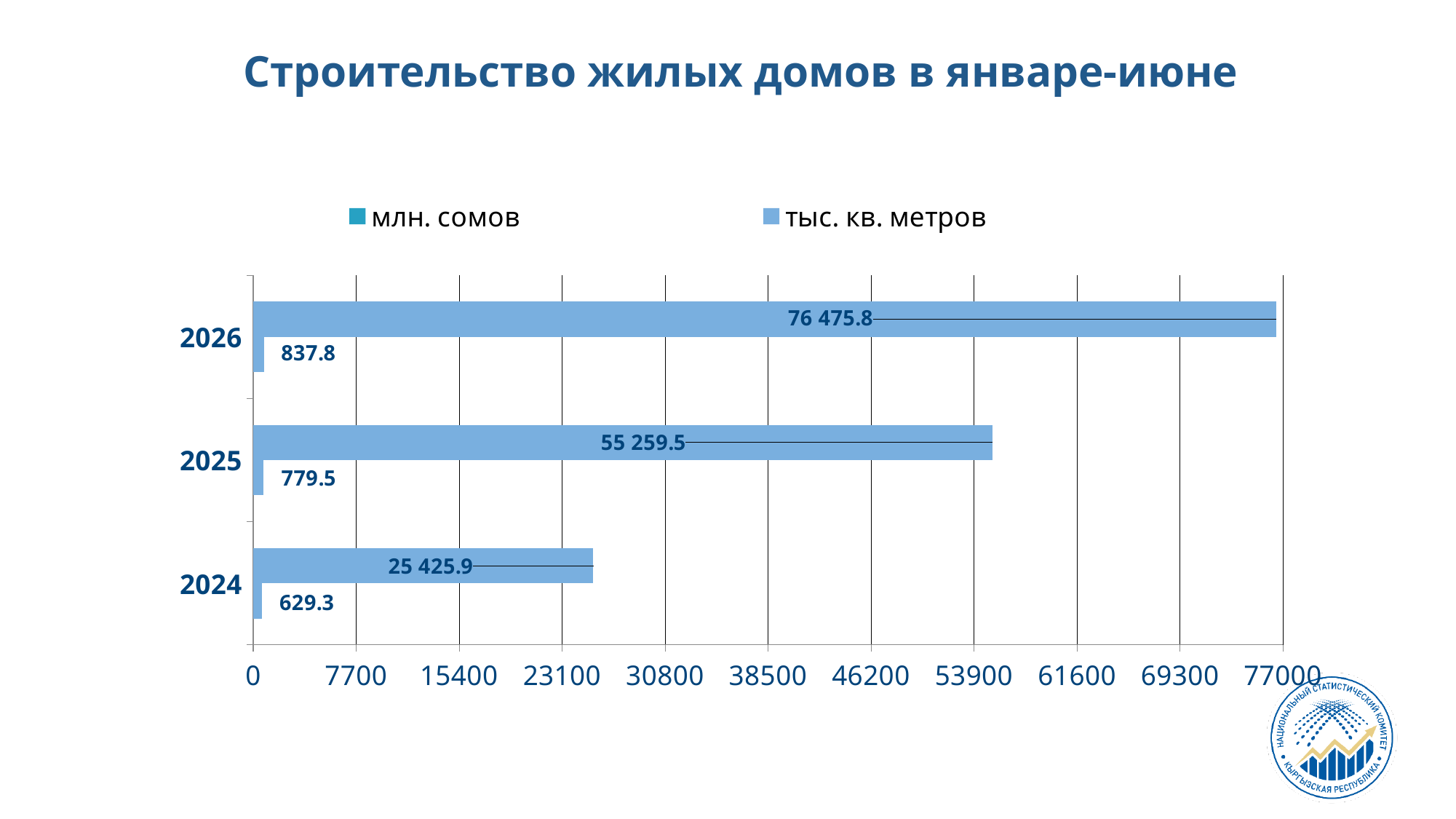
Which year has the lowest value on the short bar? 2024 What kind of chart is shown on the slide? bar chart What value is labelled on the long bar for 2026? 76 475.8 How many series does the legend list? 2 Which year has the highest value on the long bar? 2026 What is the title of the chart? Строительство жилых домов в январе-июне Is the long-bar value for 2024 greater or less than 30800? less What is the difference between the long-bar values for 2026 and 2025? 21 216.3 What value is labelled on the short bar for 2024? 629.3 How many years are shown on the chart? 3 What value is labelled on the short bar for 2026? 837.8 What value is labelled on the long bar for 2025? 55 259.5